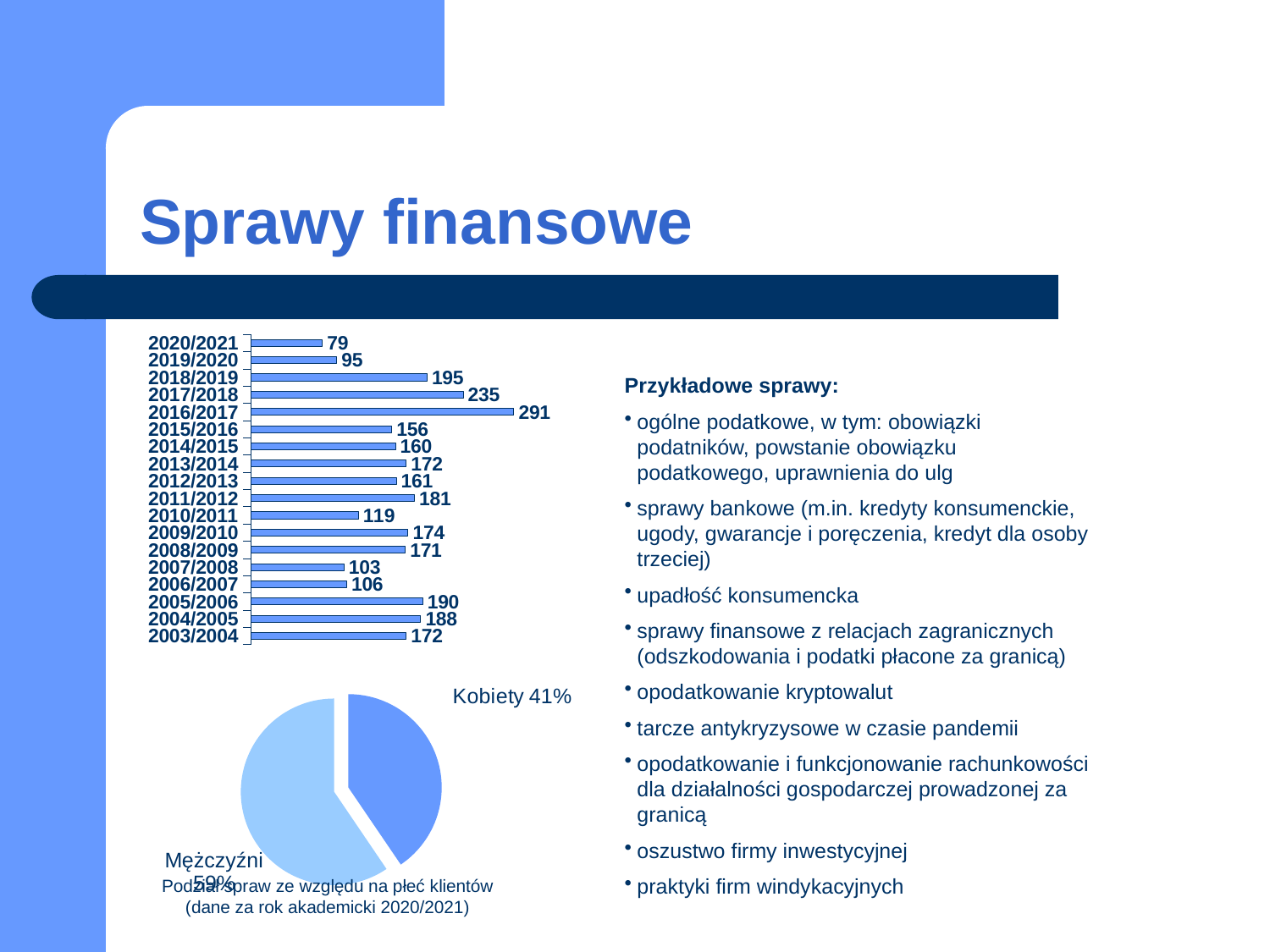
In the pie chart at the bottom left, what share is labelled Kobiety? 41% In the bar chart at the top left, what is the value for 2010/2011? 119 In the bar chart at the top left, how many academic years are shown? 18 In the pie chart at the bottom left, which slice is larger, Kobiety or Mężczyźni? Mężczyźni In the bar chart at the top left, which academic year has the lowest value? 2020/2021 What kind of chart is the chart at the bottom left of the slide? Pie chart What kind of chart is the chart at the top left of the slide? Bar chart In the bar chart at the top left, which academic year has the highest value? 2016/2017 In the bar chart at the top left, what is the value for 2020/2021? 79 In the bar chart at the top left, which is larger, the value for 2005/2006 or the value for 2004/2005? 2005/2006 In the bar chart at the top left, what is the value for 2016/2017? 291 In the bar chart at the top left, what is the difference between the values for 2017/2018 and 2018/2019? 40